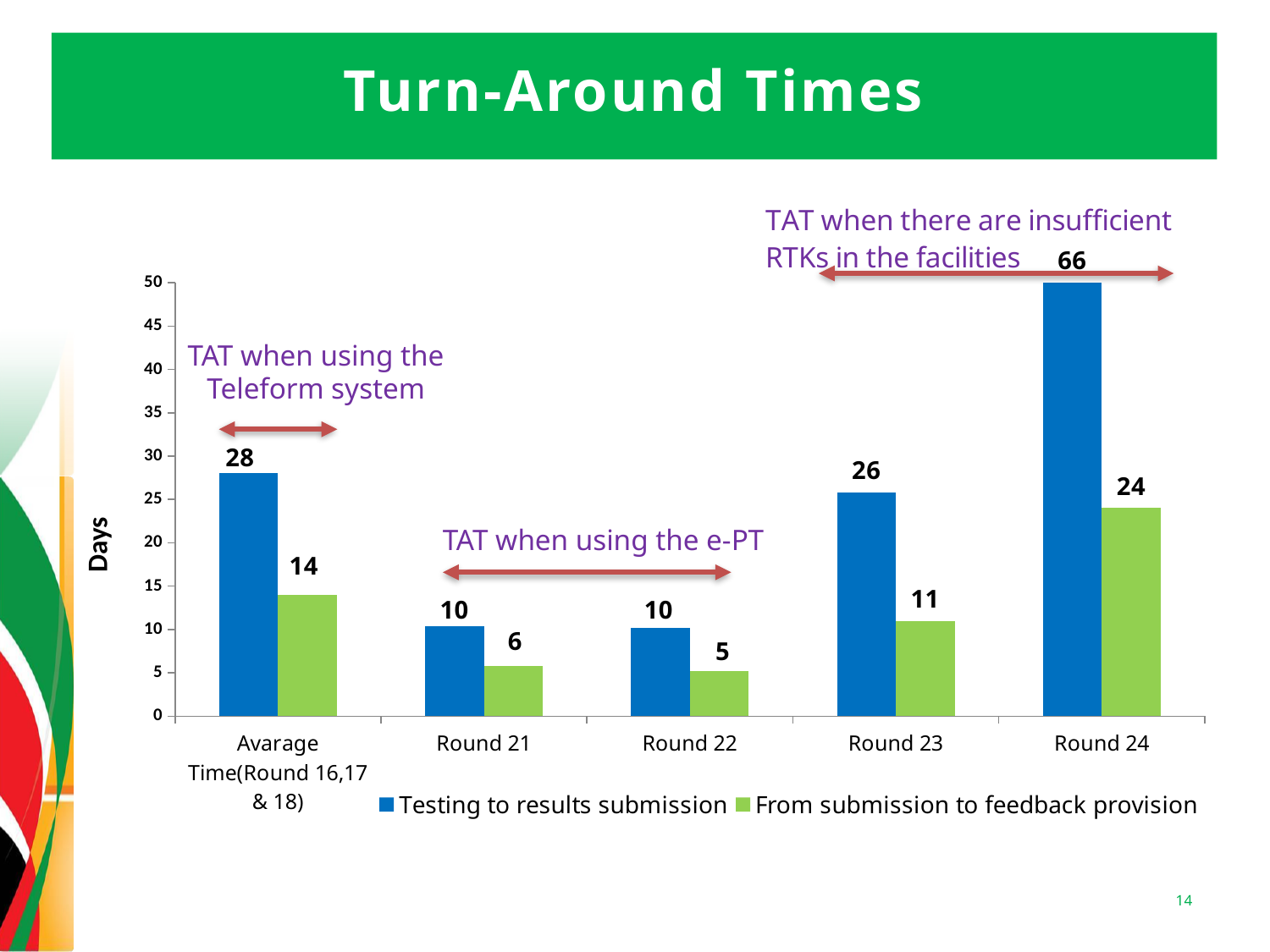
How many series does the legend list? 2 What is the value for Testing to results submission in Round 24? 66 Which category has the highest value for Testing to results submission? Round 24 What is the value for From submission to feedback provision in Round 23? 11 What is the difference between Testing to results submission and From submission to feedback provision in Round 24? 42 What is the value for Testing to results submission for Avarage Time(Round 16,17 & 18)? 28 How many categories are shown on the x axis? 5 What is the label of the y axis? Days What is the title of the slide? Turn-Around Times Which is larger: From submission to feedback provision in Round 21 or in Round 23? Round 23 What kind of chart is shown on the slide? bar chart Which category has the lowest value for From submission to feedback provision? Round 22